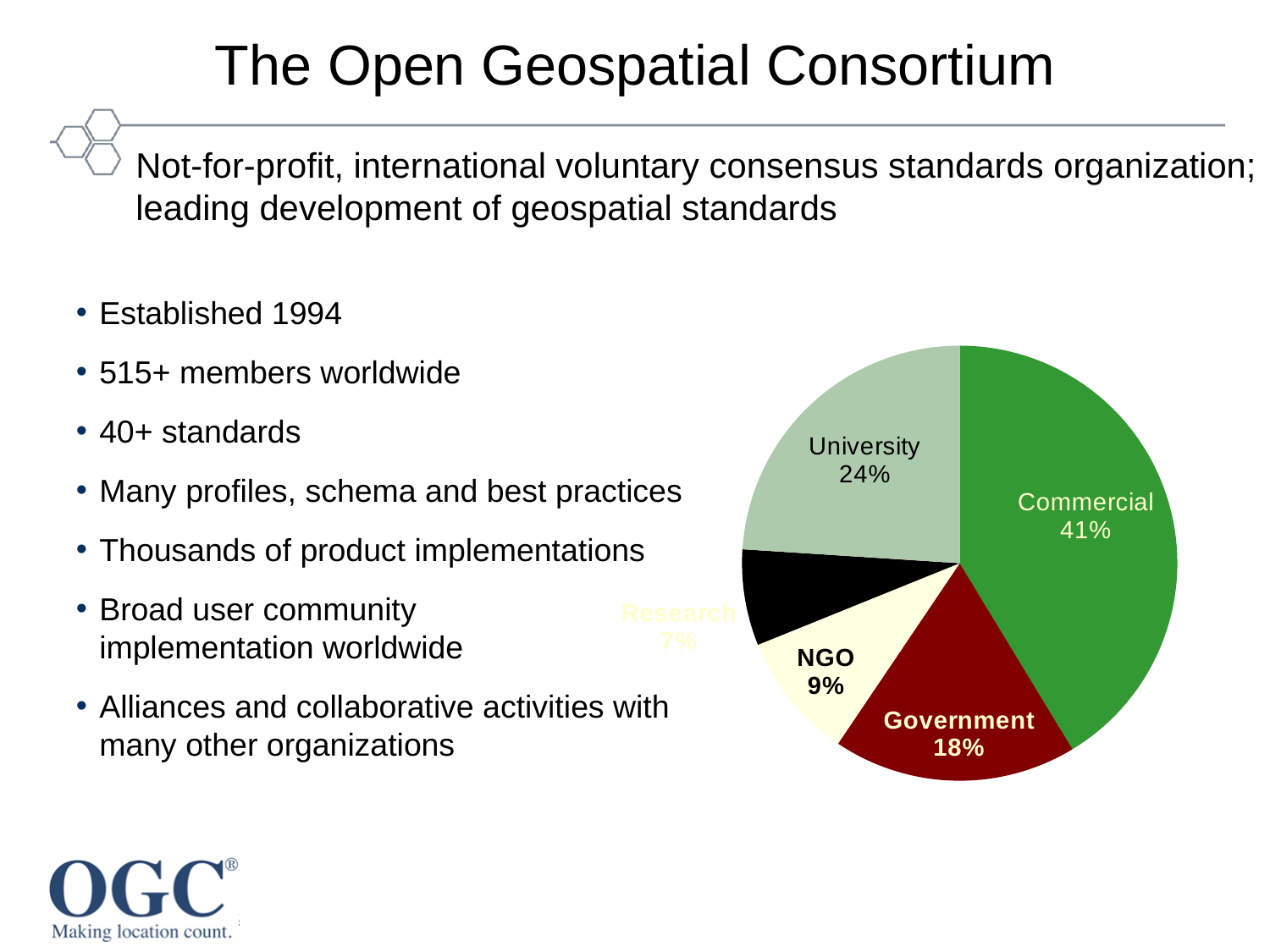
What share of the pie does Government represent? 18% What colour is the Commercial slice? green What is the difference in percentage points between the Government and NGO slices? 9 What share of the pie does University represent? 24% What share of the pie does Commercial represent? 41% Which category has the largest slice of the pie? Commercial What is the difference in percentage points between the Commercial and University slices? 17 What colour is the Government slice? dark red What share of the pie does NGO represent? 9% How many slices does the pie chart have? 5 What kind of chart is shown on the slide? pie chart Which is larger, the University slice or the Government slice? University